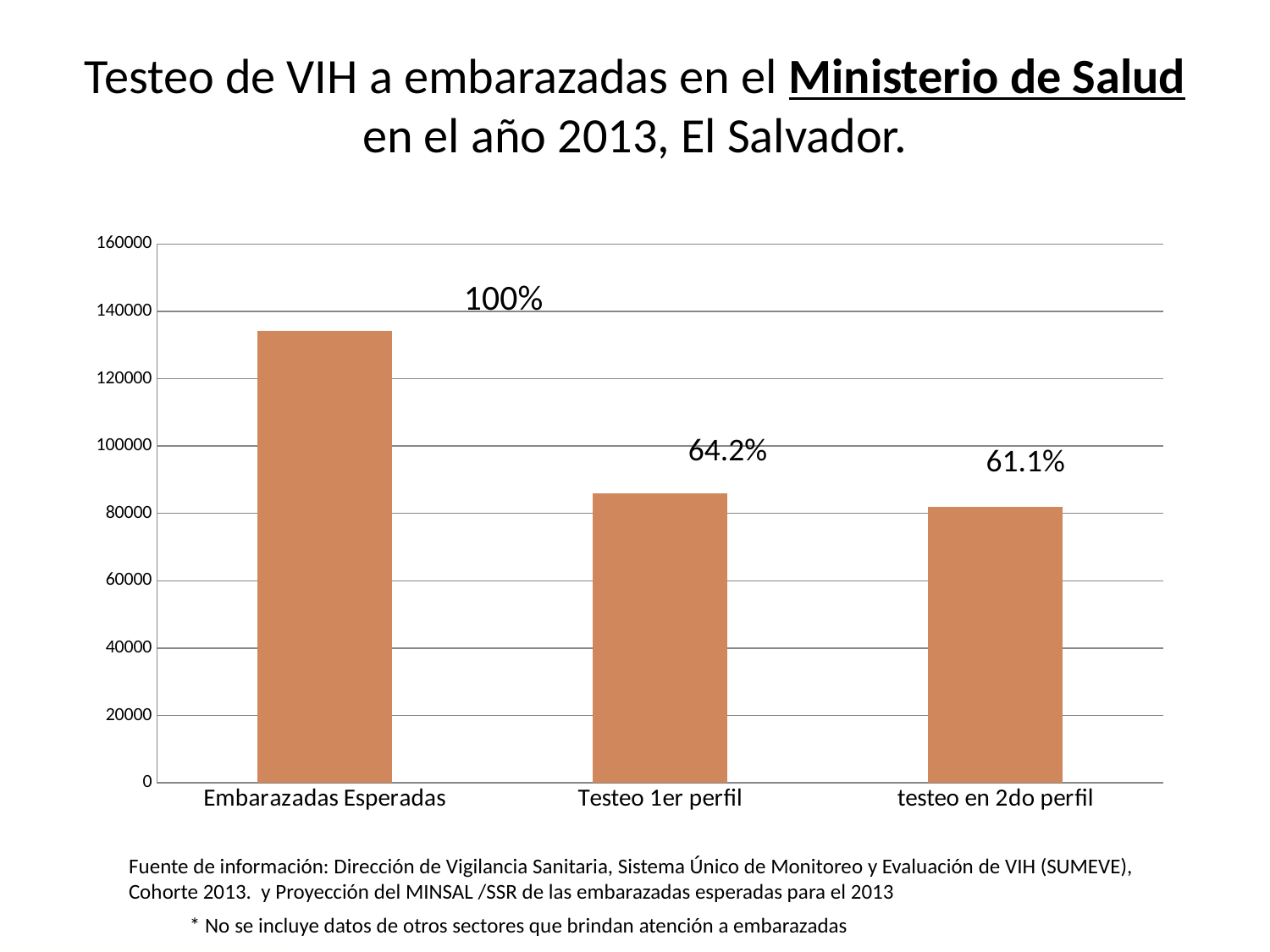
Which category has the highest bar? Embarazadas Esperadas What percentage label is shown above the Testeo 1er perfil bar? 64.2% What is the difference between the percentage labels for Embarazadas Esperadas and Testeo 1er perfil? 35.8% What percentage label is shown above the testeo en 2do perfil bar? 61.1% What percentage label is shown above the Embarazadas Esperadas bar? 100% What kind of chart is shown on the slide? Bar chart Which bar is taller, Embarazadas Esperadas or Testeo 1er perfil? Embarazadas Esperadas How many categories are shown on the x axis? 3 Is the value for Testeo 1er perfil greater or less than 100000? less Is the value for Embarazadas Esperadas greater or less than 120000? greater Is the value for testeo en 2do perfil greater or less than 60000? greater Which category has the lowest bar? testeo en 2do perfil